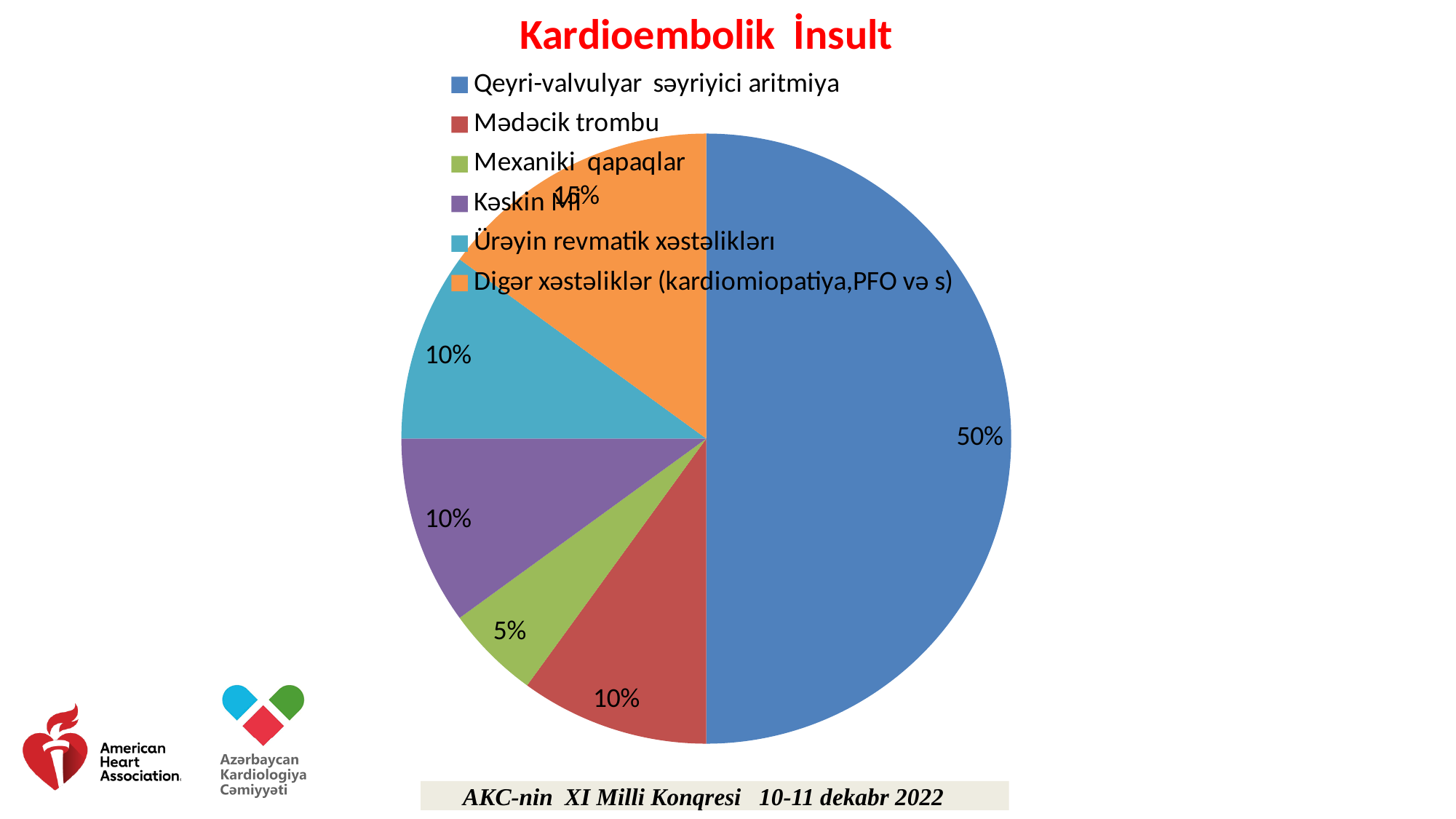
What kind of chart is shown on the slide? pie chart What share of the pie does Digər xəstəliklər (kardiomiopatiya,PFO və s) have? 15% What colour is the slice for Ürəyin revmatik xəstəlikləri? teal (light blue) What share of the pie does Qeyri-valvulyar səyriyici aritmiya have? 50% What is the title of the slide's chart? Kardioembolik İnsult What share of the pie does Mexaniki qapaqlar have? 5% What is the difference between the share for Qeyri-valvulyar səyriyici aritmiya and the share for Digər xəstəliklər (kardiomiopatiya,PFO və s)? 35% What share of the pie does Mədəcik trombu have? 10% Which is larger, the share for Digər xəstəliklər (kardiomiopatiya,PFO və s) or the share for Kəskin Mİ? Digər xəstəliklər (kardiomiopatiya,PFO və s) Which category has the smallest slice of the pie? Mexaniki qapaqlar Which category has the largest slice of the pie? Qeyri-valvulyar səyriyici aritmiya How many categories does the pie chart have? 6